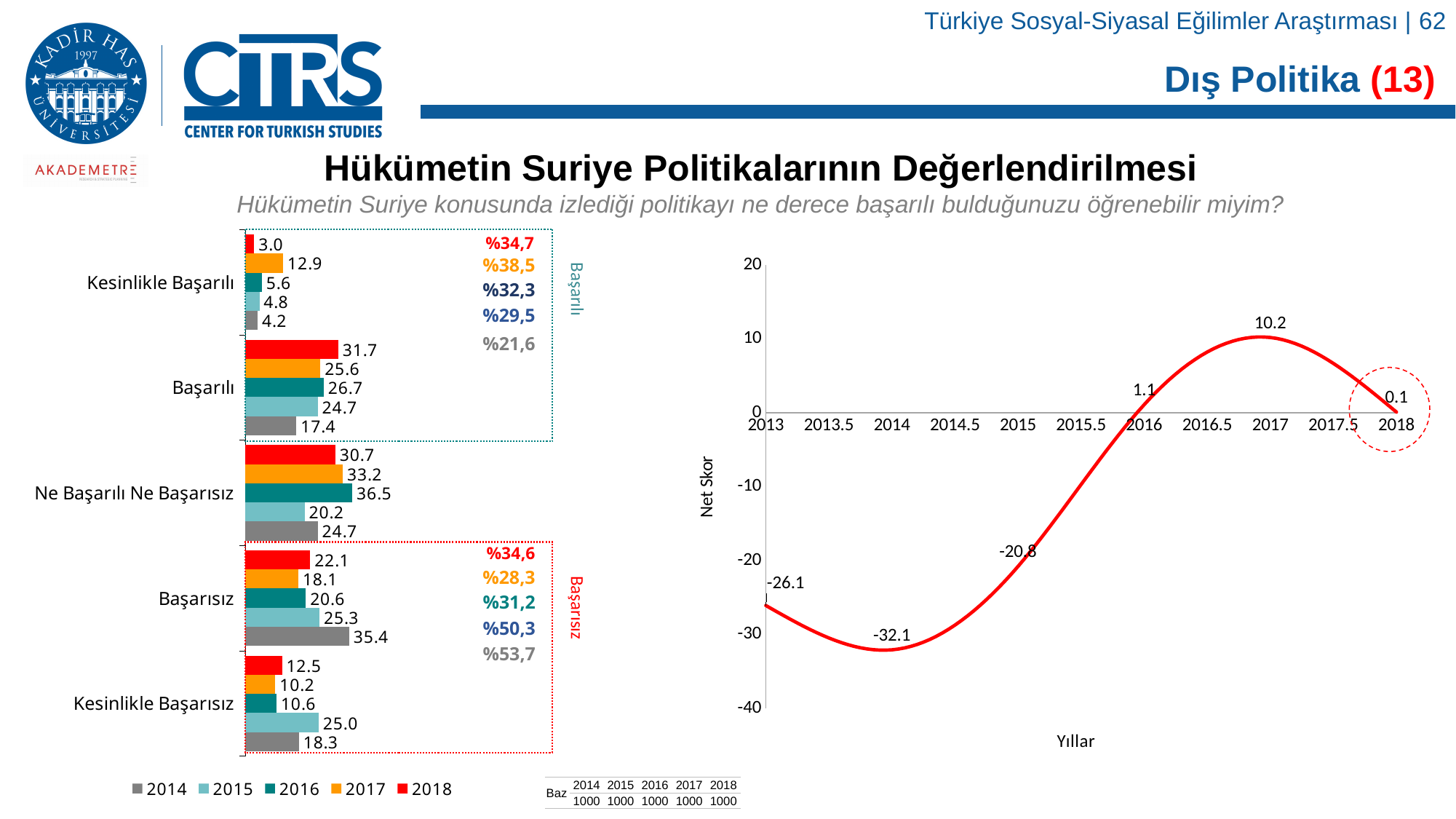
How many series does the legend of the bar chart on the left list? 5 In the bar chart on the left, which year has the highest value for Ne Başarılı Ne Başarısız? 2016 In the Net Skor line chart on the right, which year has the lowest value? 2014 In the Net Skor line chart on the right, what is the difference between the 2017 and 2018 values? 10.1 In the bar chart on the left, which year has the lowest value for Kesinlikle Başarılı? 2018 In the bar chart on the left, which is larger for Başarısız: the 2015 value or the 2017 value? 2015 In the bar chart on the left, what is the 2018 value for Başarılı? 31.7 How many categories are shown in the bar chart on the left? 5 In the bar chart on the left, what is the 2014 value for Başarısız? 35.4 What kind of chart is the Net Skor chart on the right? line chart In the Net Skor line chart on the right, what is the value for 2017? 10.2 In the bar chart on the left, what is the difference between the 2015 and 2018 values for Kesinlikle Başarısız? 12.5